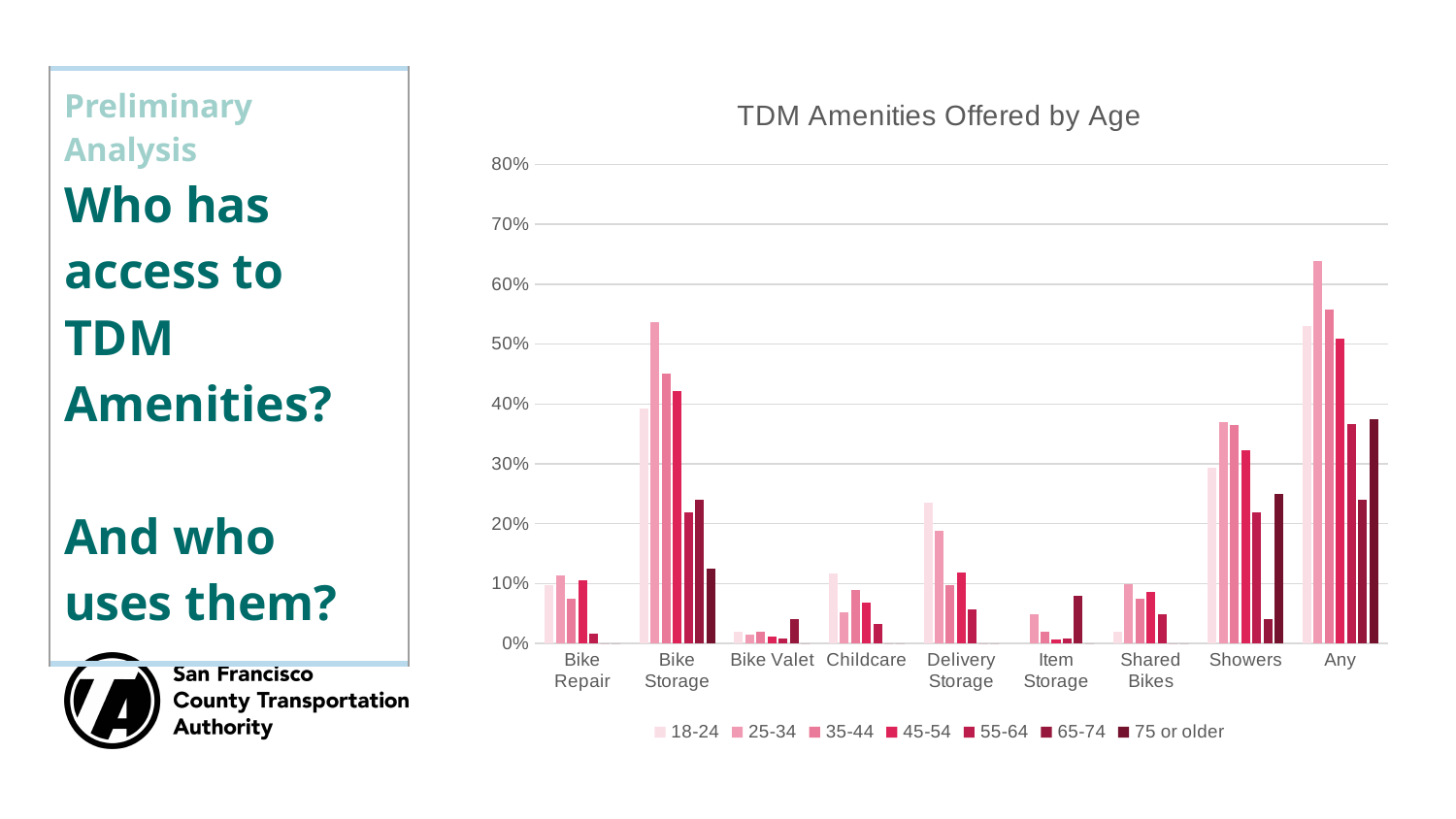
Is the value for the 25-34 age group in the Any category greater or less than 60%? greater How many age groups does the legend list? 7 Is the value for the 75 or older age group in the Bike Repair category greater or less than 10%? less In the Showers category, which is larger: the value for 18-24 or the value for 25-34? 25-34 For the 18-24 age group, which is larger: the value for Bike Storage or the value for Showers? Bike Storage For the 25-34 age group, which amenity category has the highest value? Any How many amenity categories are shown on the x axis? 9 Is the value for the 25-34 age group in the Bike Storage category greater or less than 50%? greater What is the title of the chart? TDM Amenities Offered by Age What kind of chart is shown on the slide? bar chart For the 25-34 age group, which amenity category has the lowest value? Bike Valet